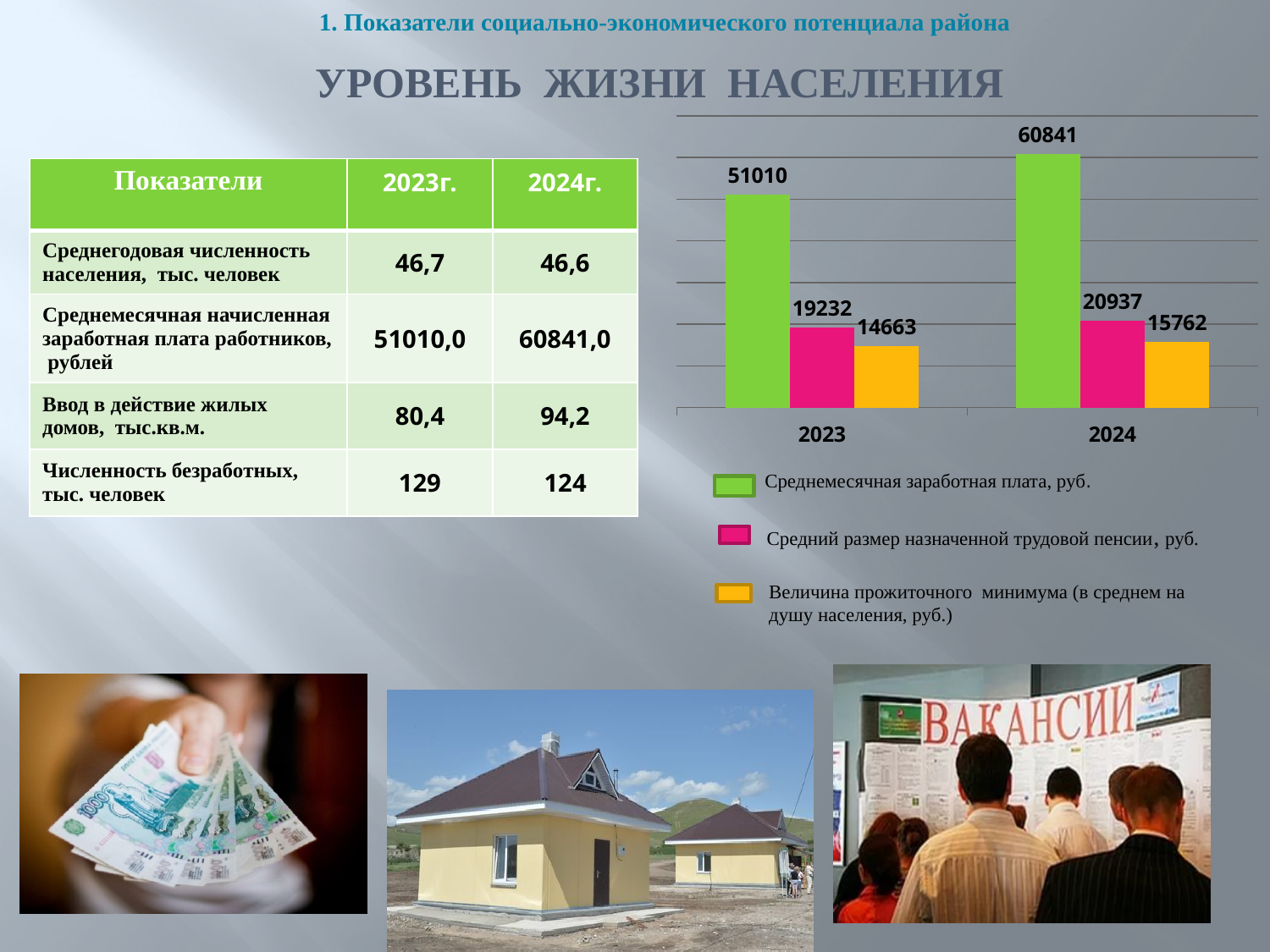
What is the subsistence minimum (Величина прожиточного минимума) shown in the chart for 2024? 15762 What type of chart is used to show the living standard indicators? Bar chart What is the average assigned labour pension (Средний размер назначенной трудовой пенсии) shown in the chart for 2023? 19232 Which colour represents the average monthly salary series in the chart? Green What is the subsistence minimum (Величина прожиточного минимума) shown in the chart for 2023? 14663 How many year categories are shown on the x axis of the chart? 2 Which year has the higher average monthly salary in the chart, 2023 or 2024? 2024 Which series has the lowest value in 2023 in the chart? Величина прожиточного минимума (в среднем на душу населения, руб.) How many series does the chart's legend list? 3 What is the average monthly salary (Среднемесячная заработная плата) shown in the chart for 2024? 60841 By how much did the average monthly salary in the chart increase from 2023 to 2024? 9831 What is the difference between the average pension and the subsistence minimum in 2024 according to the chart? 5175